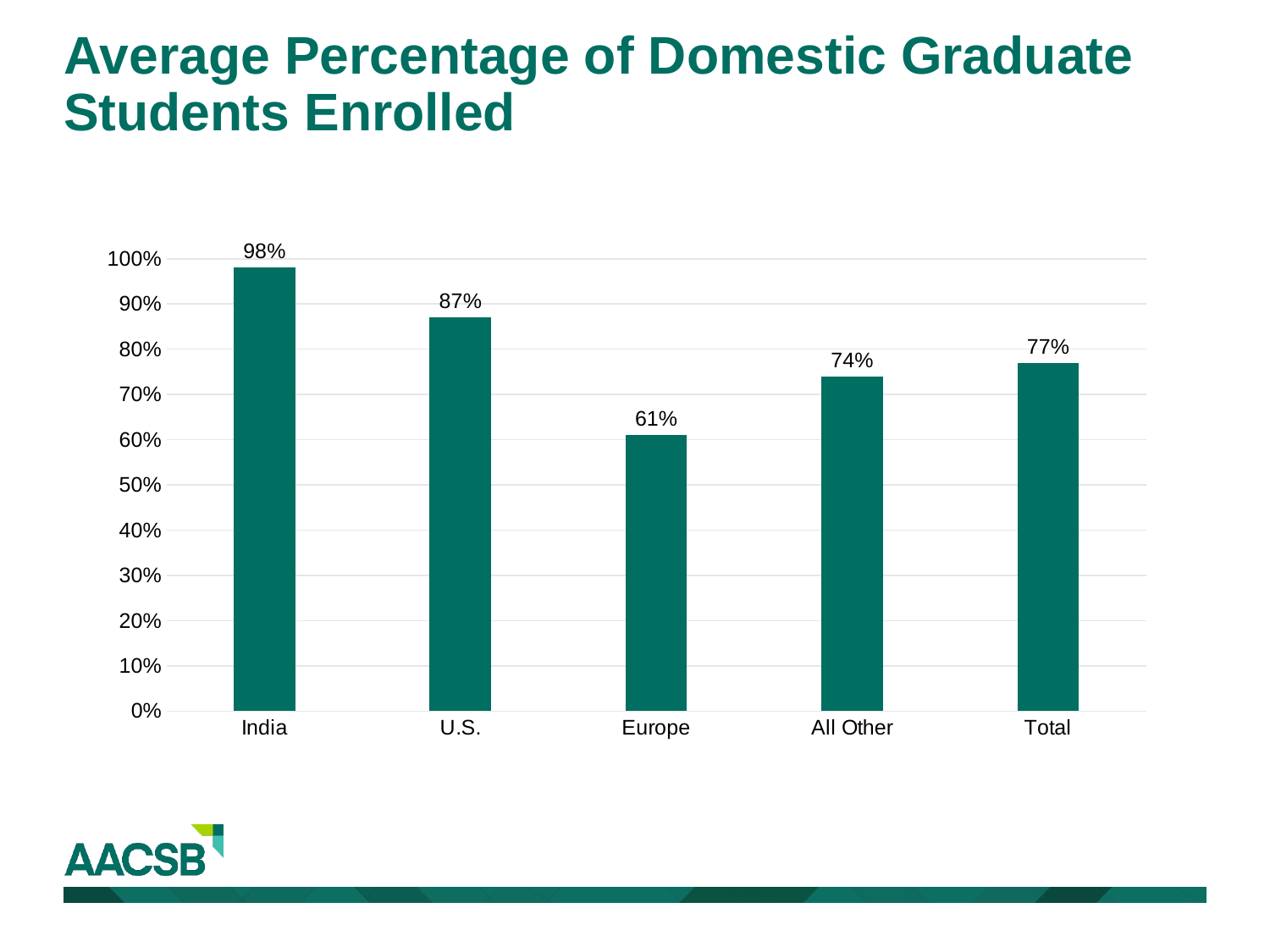
What is the value shown for All Other? 74% What is the average percentage of domestic graduate students enrolled for India? 98% What is the difference between the values for Total and Europe? 16% What is the title of the chart? Average Percentage of Domestic Graduate Students Enrolled What is the value shown for Europe? 61% What kind of chart is shown on the slide? Bar chart How many categories are shown on the x axis? 5 What is the value shown for Total? 77% What is the difference between the values for India and the U.S.? 11% Which category has the highest value? India Which is larger, the value for the U.S. or the value for All Other? U.S. Which category has the lowest value? Europe